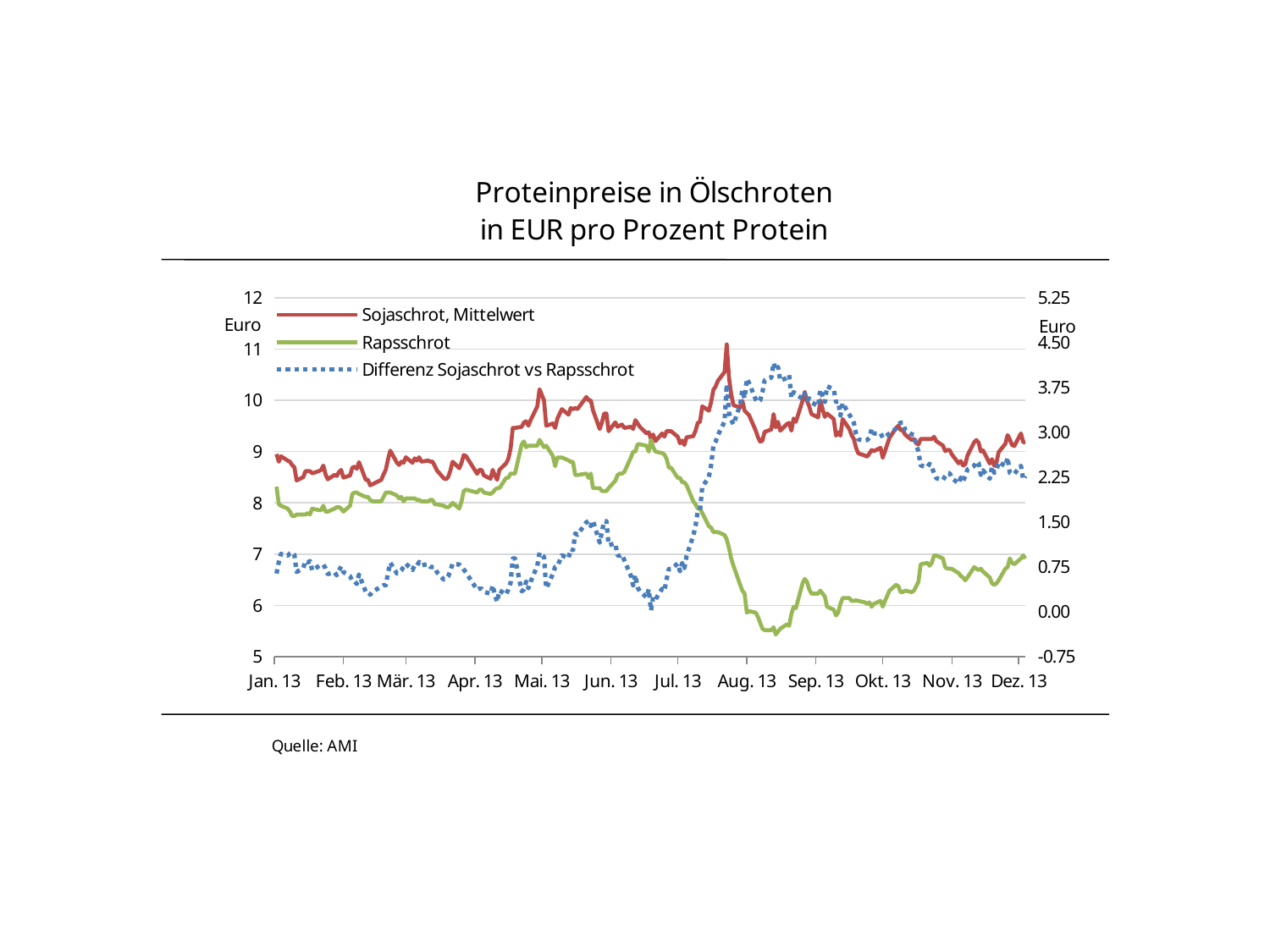
What is the source given below the chart? AMI Does the Rapsschrot line rise or fall between Jun. 13 and Aug. 13? fall How many month labels are shown on the x axis? 12 Is the peak value for Sojaschrot, Mittelwert in early Aug. 13 greater or less than 10? greater Which series has the higher value in Aug. 13, Sojaschrot, Mittelwert or Rapsschrot? Sojaschrot, Mittelwert Is the value for Differenz Sojaschrot vs Rapsschrot in Jan. 13 greater or less than 1.50 on the right axis? less How many series does the legend list? 3 Is the lowest value for Rapsschrot around Aug. 13 greater or less than 6? less Which series is drawn as a dotted line? Differenz Sojaschrot vs Rapsschrot What kind of chart is shown on the slide? line chart